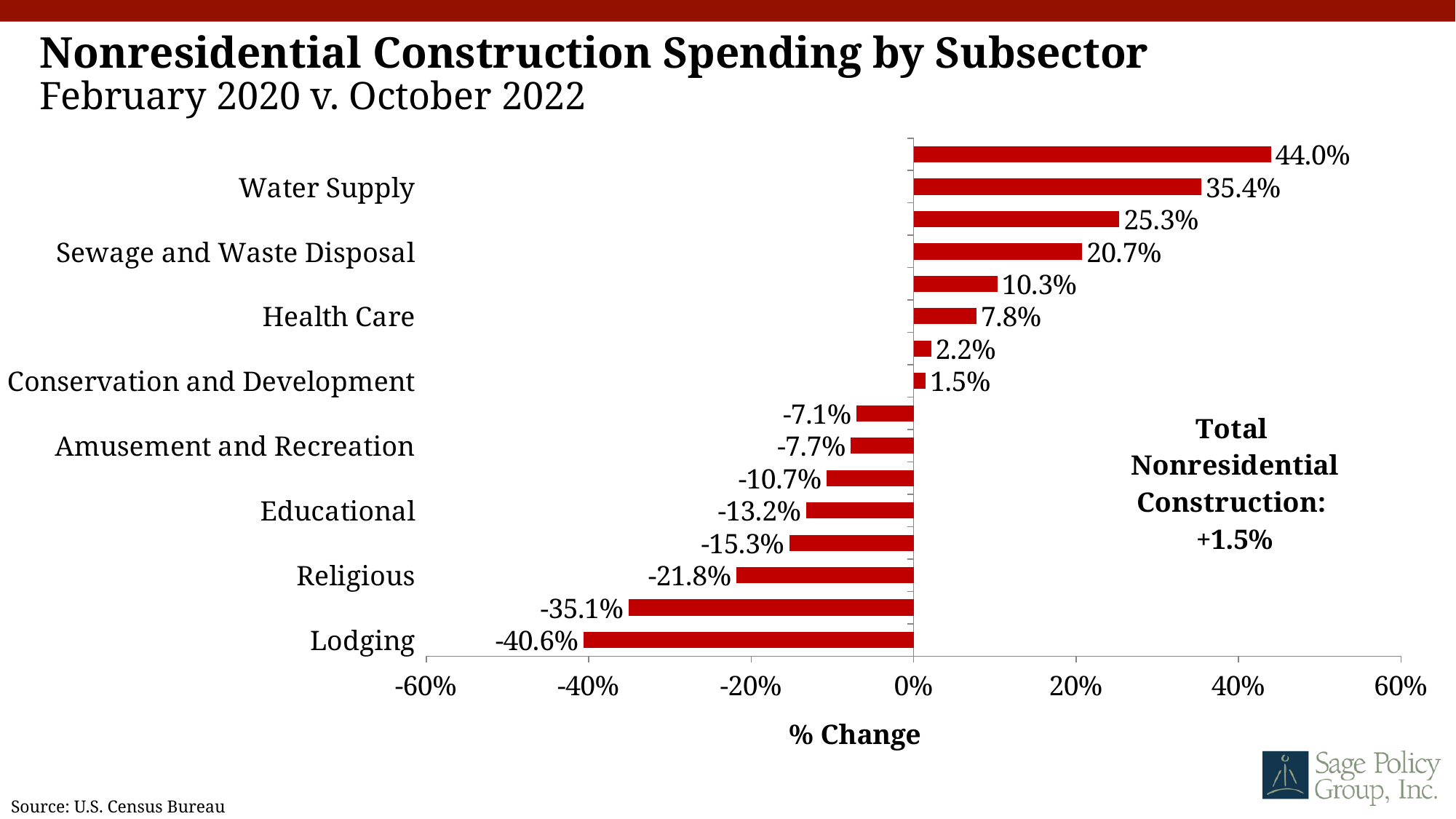
Which shows a larger percentage decline, Religious or Educational? Religious What is the percentage change for Water Supply? 35.4% How many percentage points higher is Water Supply than Sewage and Waste Disposal? 14.7 percentage points What is the total nonresidential construction percentage change noted on the chart? +1.5% What is the highest percentage change value shown on the chart? 44.0% Which labeled subsector has the lowest percentage change? Lodging What is the percentage change for Health Care? 7.8% What kind of chart is shown on the slide? Bar chart What is the percentage change for Conservation and Development? 1.5% How many bars are plotted on the chart? 16 What is the percentage change for Lodging? -40.6% What is the percentage change for Educational? -13.2%